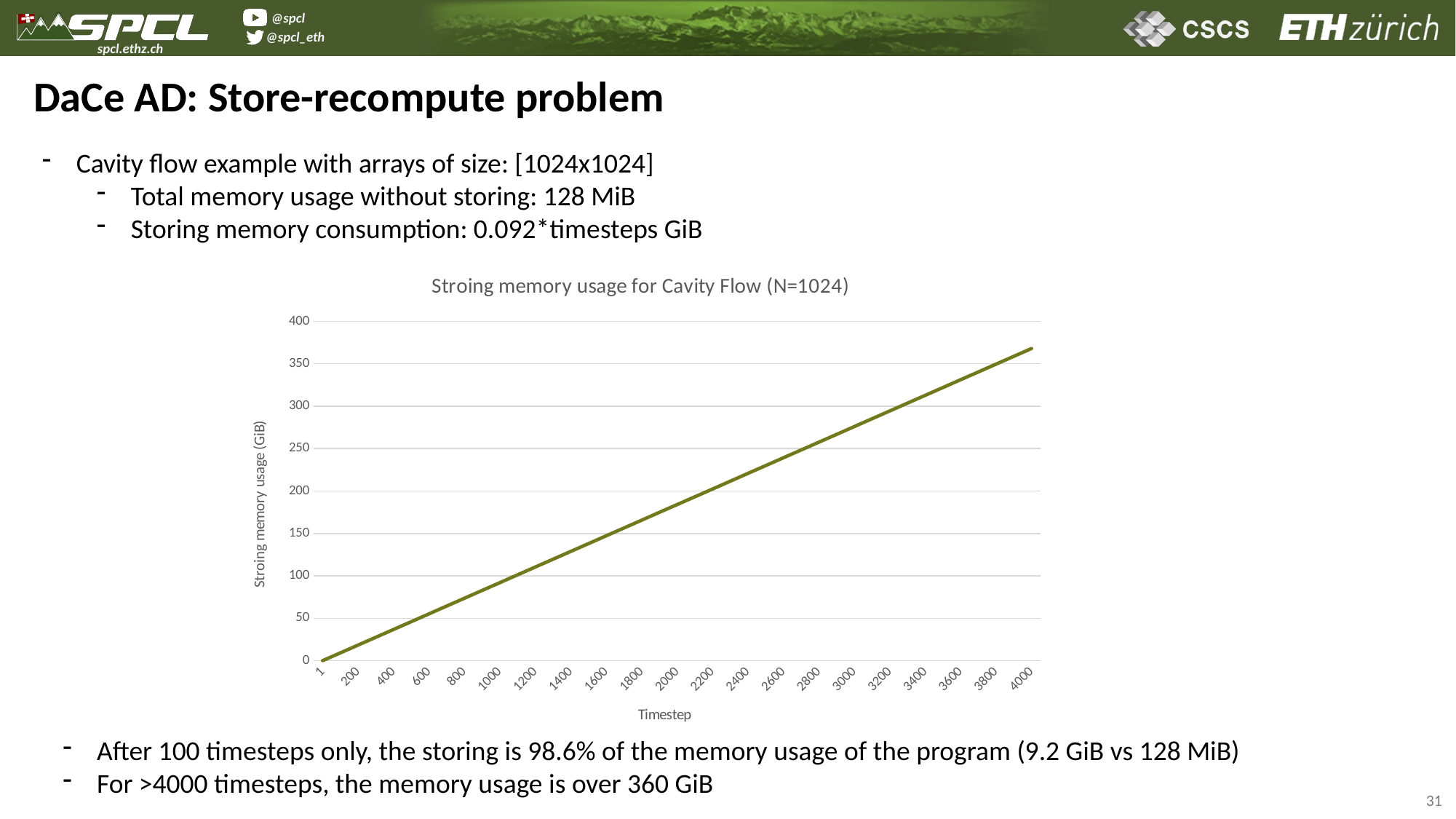
Is the storing memory usage at timestep 2000 greater or less than 200? less At which labelled timestep is the storing memory usage highest? 4000 Is the storing memory usage at timestep 3000 greater or less than 250? greater Which has higher storing memory usage, timestep 1200 or timestep 2800? 2800 What is the label of the x axis of the chart? Timestep Does the storing memory usage rise or fall as the timestep increases? rise What is the title of the chart? Stroing memory usage for Cavity Flow (N=1024) Is the storing memory usage at timestep 4000 greater or less than 350? greater What kind of chart is shown on the slide? line chart How many tick labels are shown on the x axis of the chart? 21